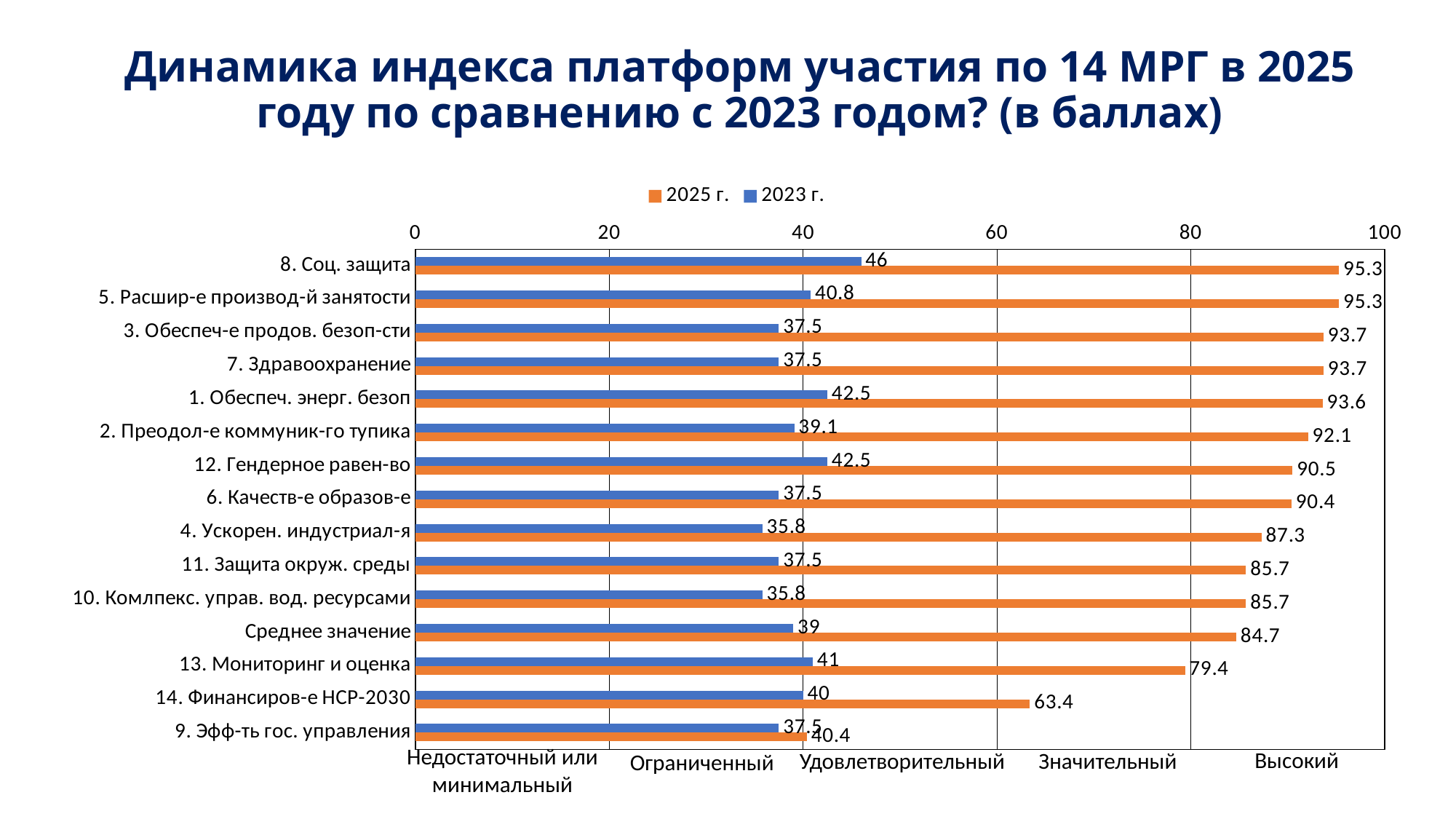
How many categories are shown on the vertical axis of the chart? 15 What is the 2025 г. value for 8. Соц. защита? 95.3 Which category has the lowest 2025 г. value? 9. Эфф-ть гос. управления How many series does the legend list? 2 Which category has the highest 2023 г. value? 8. Соц. защита What kind of chart is shown on the slide? Bar chart Is the 2025 г. value for 14. Финансиров-е НСР-2030 greater or less than 80? less What is the 2025 г. value for Среднее значение? 84.7 What is the 2023 г. value for 14. Финансиров-е НСР-2030? 40 Which colour represents the 2023 г. series in the chart? Blue What is the difference between the 2025 г. and 2023 г. values for 13. Мониторинг и оценка? 38.4 Which is larger: the 2025 г. value for 4. Ускорен. индустриал-я or the 2025 г. value for 12. Гендерное равен-во? 12. Гендерное равен-во